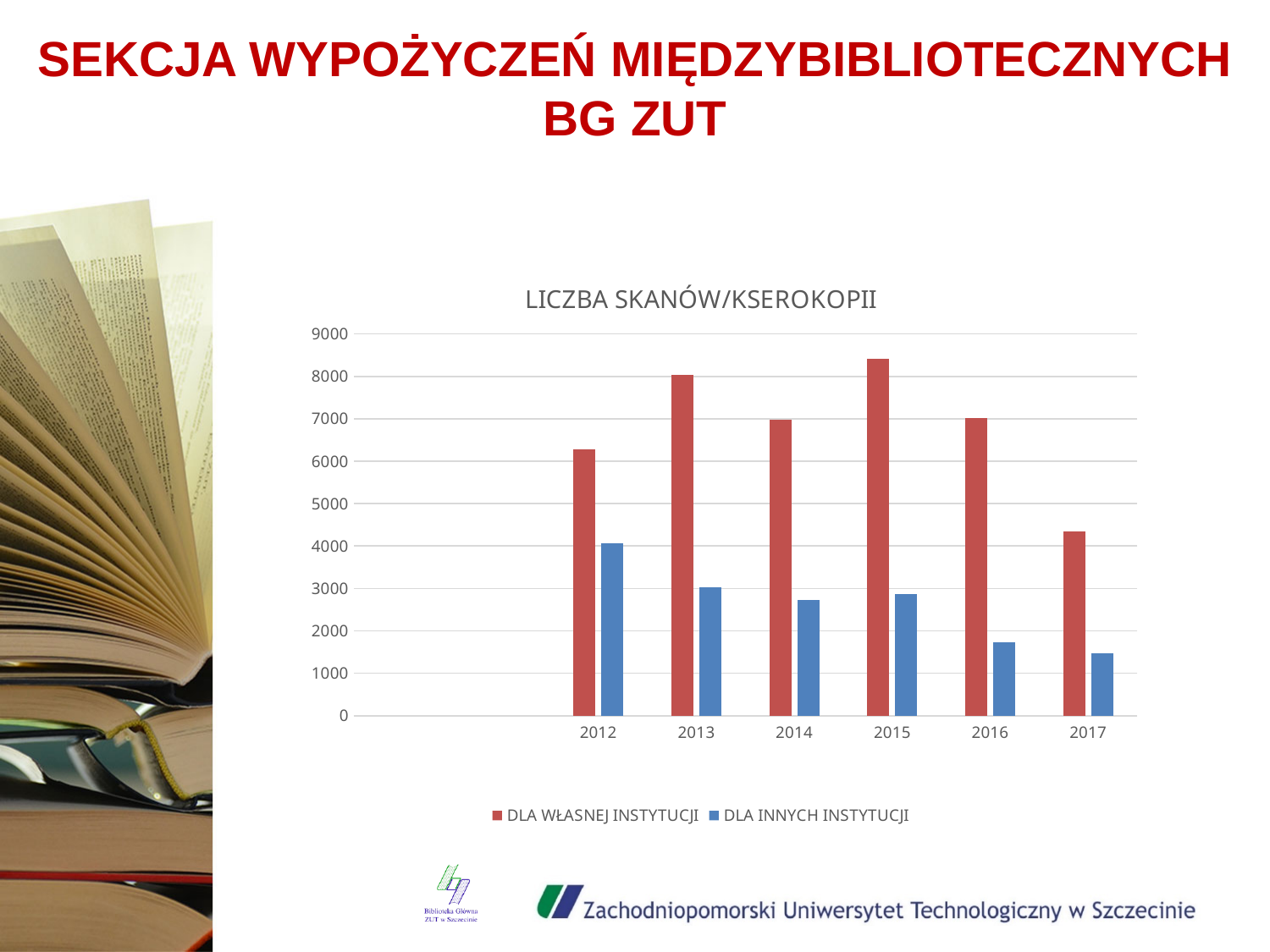
Is the value for DLA WŁASNEJ INSTYTUCJI in 2012 greater or less than 6000? greater In which year is the value for DLA WŁASNEJ INSTYTUCJI lowest? 2017 Is the value for DLA INNYCH INSTYTUCJI in 2016 greater or less than 2000? less What kind of chart is shown on the slide? bar chart Which is larger in 2013: the value for DLA WŁASNEJ INSTYTUCJI or DLA INNYCH INSTYTUCJI? DLA WŁASNEJ INSTYTUCJI What is the title of the chart? LICZBA SKANÓW/KSEROKOPII In which year is the value for DLA INNYCH INSTYTUCJI highest? 2012 Is the value for DLA WŁASNEJ INSTYTUCJI in 2017 greater or less than 5000? less In which year is the value for DLA INNYCH INSTYTUCJI lowest? 2017 How many series does the legend list? 2 In which year is the value for DLA WŁASNEJ INSTYTUCJI highest? 2015 How many years are shown on the x axis? 6